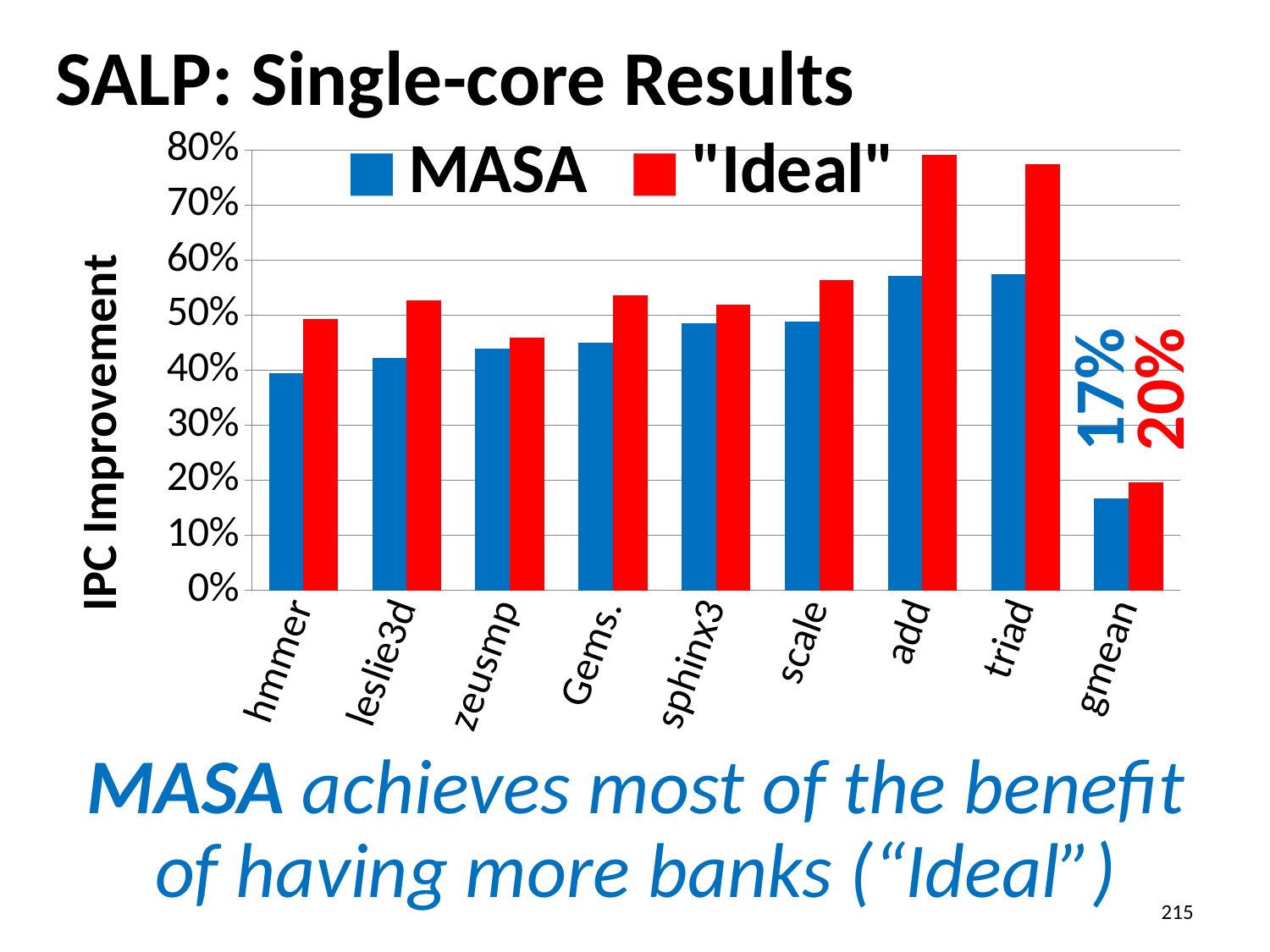
For hmmer, which is larger: the MASA value or the "Ideal" value? "Ideal" What are the two series named in the legend? MASA and "Ideal" Is the "Ideal" value for add greater or less than 70%? greater How many series does the legend list? 2 What is the label of the y axis? IPC Improvement Is the "Ideal" value for zeusmp greater or less than 50%? less What type of chart is shown on the slide? bar chart What is the difference between the "Ideal" and MASA values for gmean? 3% What is the MASA IPC improvement for gmean? 17% What is the "Ideal" IPC improvement for gmean? 20% How many categories are shown on the x axis? 9 Which category has the lowest MASA value? gmean